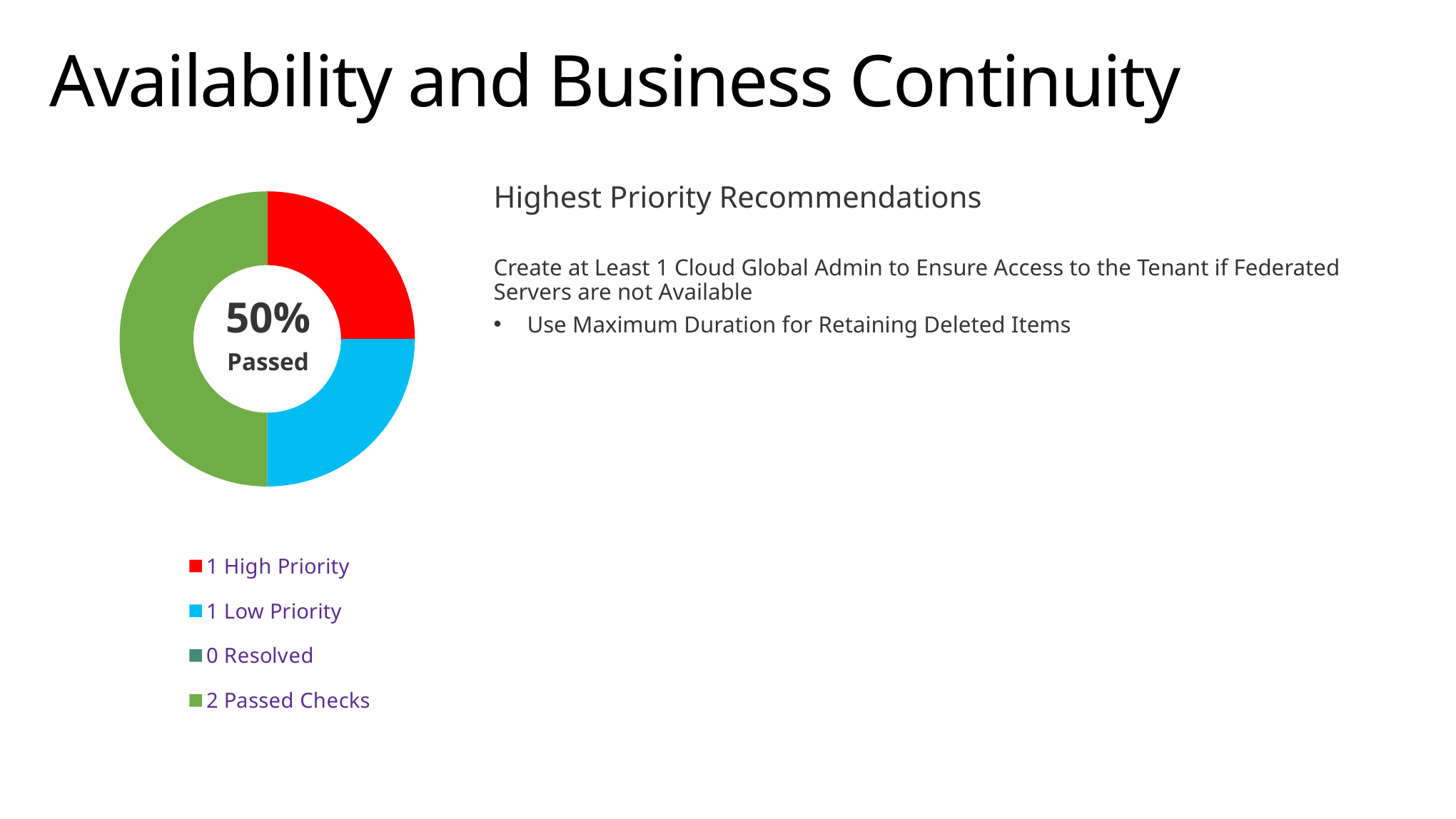
How many Passed Checks does the legend show? 2 What kind of chart is shown on the slide? Donut chart What colour represents Passed Checks in the chart? Green Which category has the smallest count in the chart? Resolved How many High Priority items does the legend show? 1 How many entries does the legend list? 4 What is the difference between the Passed Checks count and the High Priority count? 1 How many Resolved items does the legend show? 0 What percentage is shown in the centre of the donut chart? 50% Which is larger, the Passed Checks count or the Low Priority count? Passed Checks Which category has the largest count in the chart? Passed Checks What is the total of all counts listed in the legend? 4